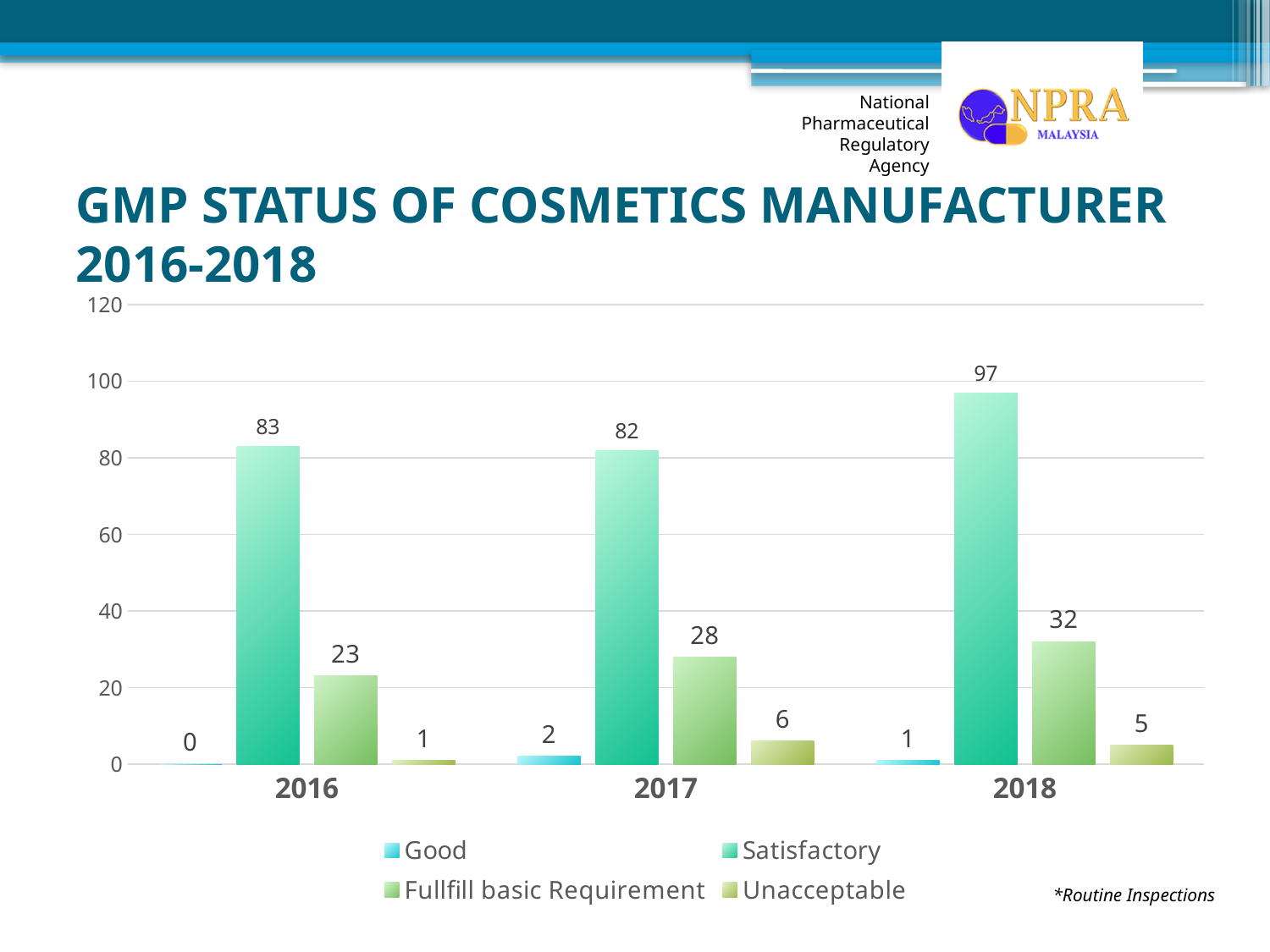
How many years are shown on the x axis? 3 How many series does the legend list? 4 What is the value for Unacceptable in 2017? 6 What is the value for Satisfactory in 2018? 97 What is the value for Good in 2017? 2 What is the value for Fullfill basic Requirement in 2016? 23 Does the Fullfill basic Requirement value rise or fall from 2016 to 2018? Rise What kind of chart is shown on the slide? Bar chart What is the difference between the Satisfactory values for 2018 and 2017? 15 In which year is the Good value lowest? 2016 Which is larger, Fullfill basic Requirement in 2017 or in 2018? 2018 In which year is the Satisfactory value highest? 2018